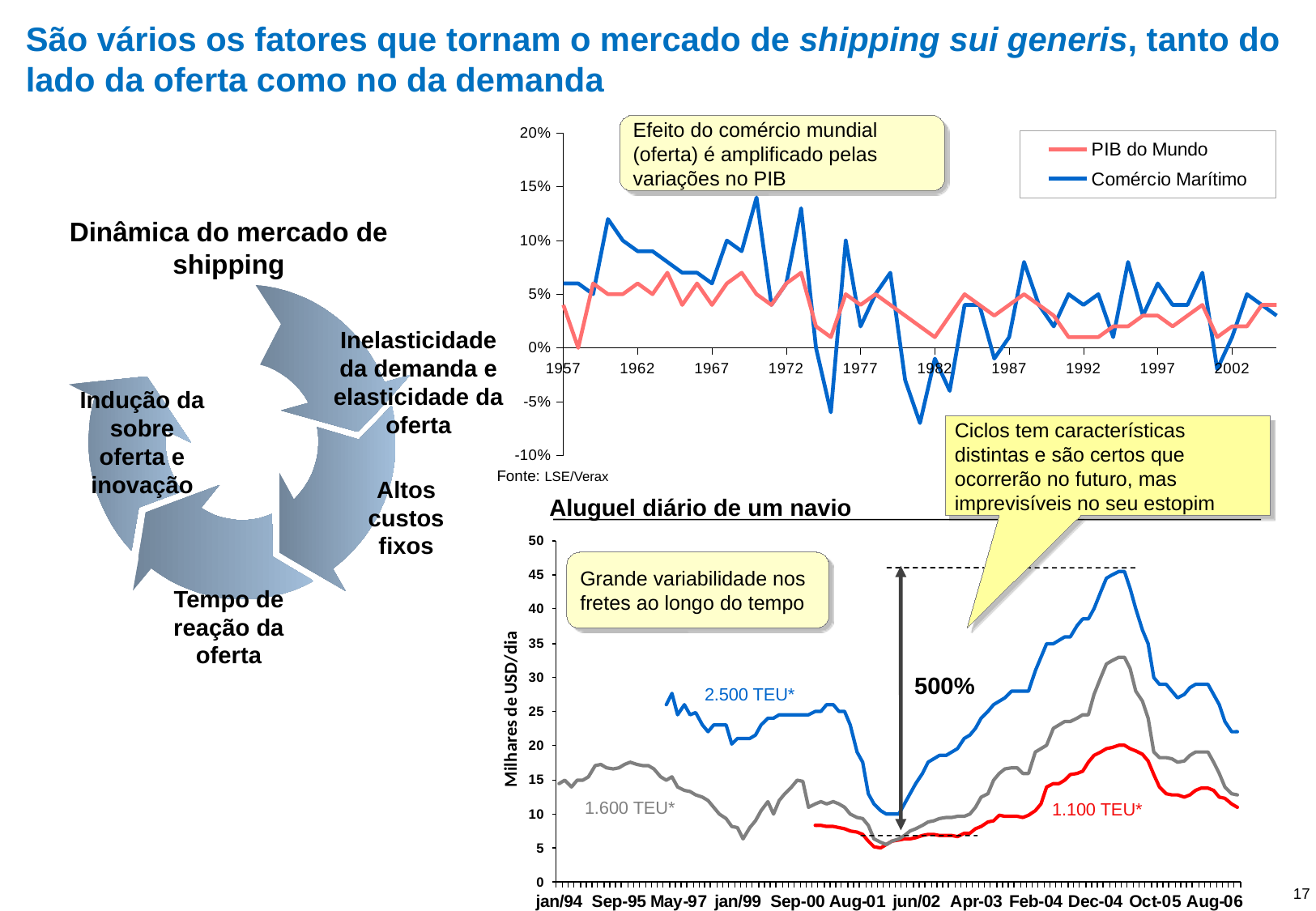
In the bottom chart 'Aluguel diário de um navio', which series reaches the highest value? 2.500 TEU* What kind of chart is the bottom chart 'Aluguel diário de um navio'? Line chart How many series are plotted in the bottom chart 'Aluguel diário de um navio'? 3 What is the source cited below the top chart? LSE/Verax In the top chart, which series reaches the highest value over the period? Comércio Marítimo What is the title of the bottom chart? Aluguel diário de um navio How many series does the legend of the top chart list? 2 In the top chart, is the peak value of Comércio Marítimo around 1970 greater or less than 10%? greater In the top chart, is the lowest value of Comércio Marítimo (around 1982) greater or less than -5%? less In the bottom chart 'Aluguel diário de um navio', is the peak value of the 2.500 TEU* series around Dec-04 greater or less than 40? greater What kind of chart is the top chart comparing PIB do Mundo and Comércio Marítimo? Line chart